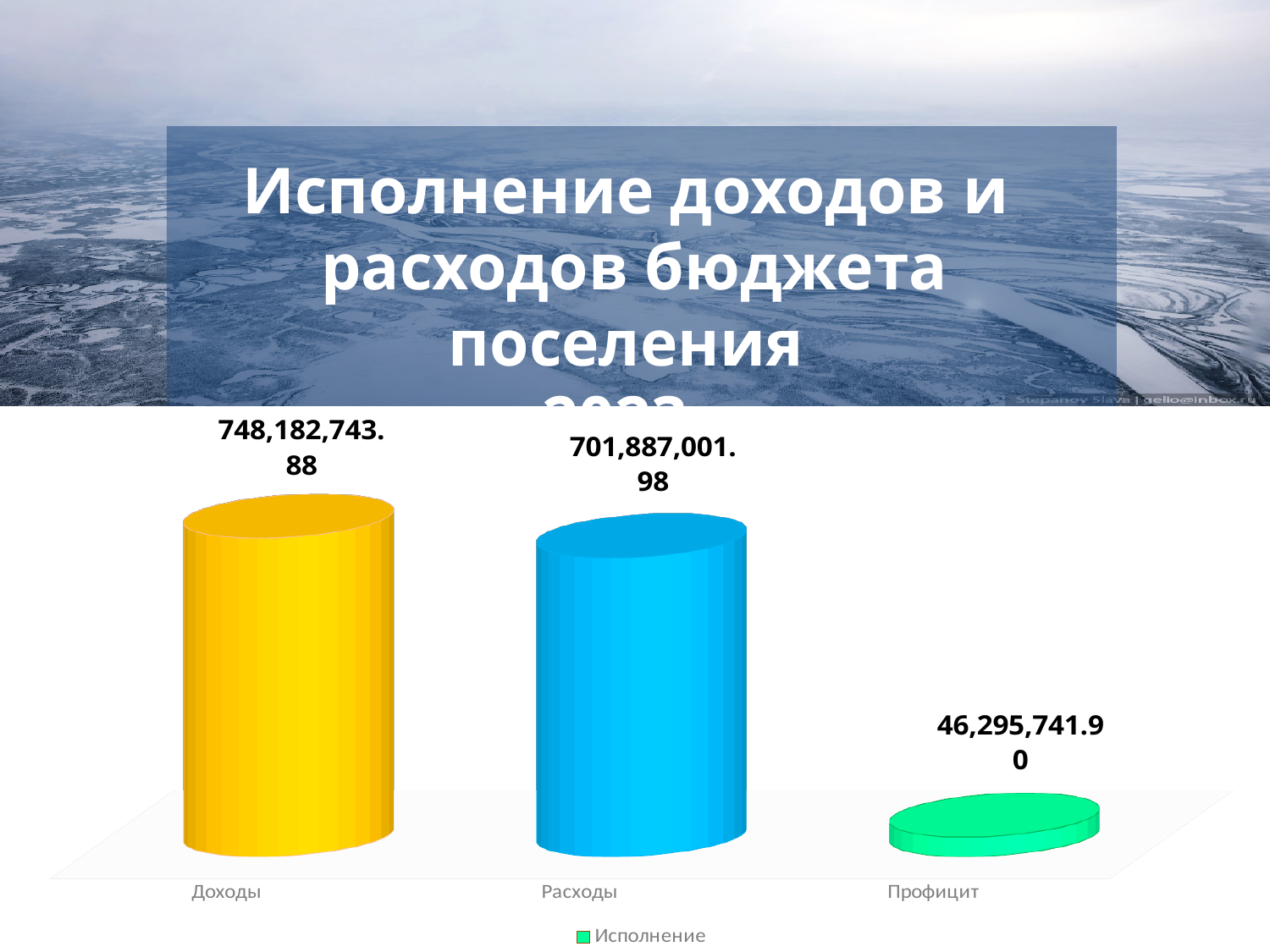
How many series does the legend list? 1 What is the difference between the values for Доходы and Расходы? 46,295,741.90 What is the value for Доходы? 748,182,743.88 What is the value for Профицит? 46,295,741.90 What is the name of the series shown in the legend? Исполнение Which category has the lowest value? Профицит Which is larger, the value for Расходы or the value for Профицит? Расходы Which category has the highest value? Доходы What colour is the bar for Расходы? Blue What kind of chart is shown on the slide? Bar chart How many categories are shown on the chart? 3 What is the value for Расходы? 701,887,001.98